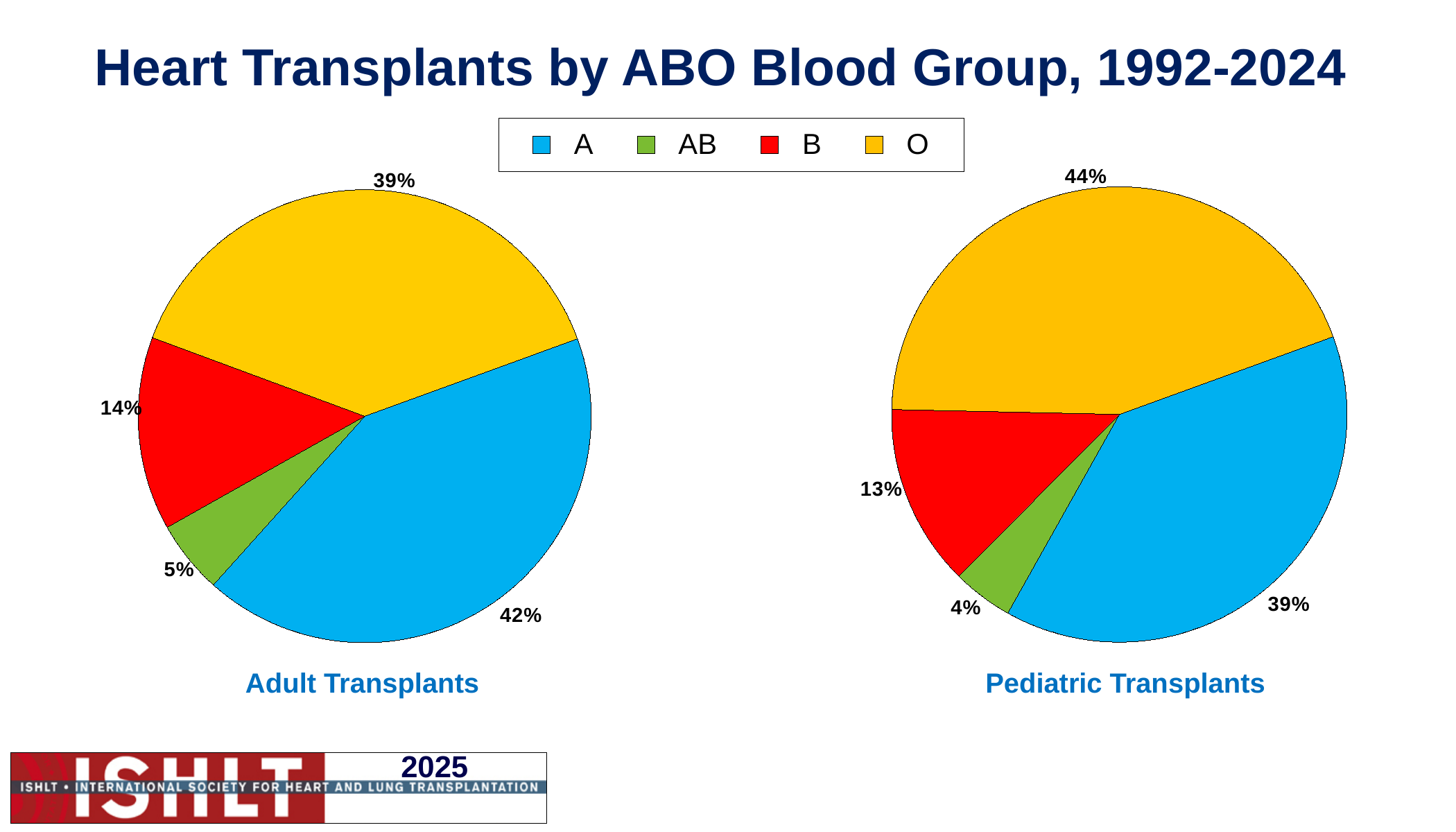
In the Adult Transplants pie chart, what share of heart transplants is blood group A? 42% What kind of chart is used for the Adult Transplants data? pie chart In the Pediatric Transplants pie chart, what share is blood group B? 13% In the Adult Transplants pie chart, what share is blood group AB? 5% Which colour represents blood group B in the legend? red In the Adult Transplants pie chart, which blood group has the largest share? A In the Pediatric Transplants pie chart, which blood group has the smallest share? AB In the Pediatric Transplants pie chart, what share of heart transplants is blood group O? 44% How many blood groups does the legend list? 4 In the Pediatric Transplants pie chart, which blood group has the largest share? O In the Pediatric Transplants pie chart, is the share of blood group O larger or smaller than the share of blood group A? larger In the Adult Transplants pie chart, what is the difference between the shares of blood group A and blood group O? 3%